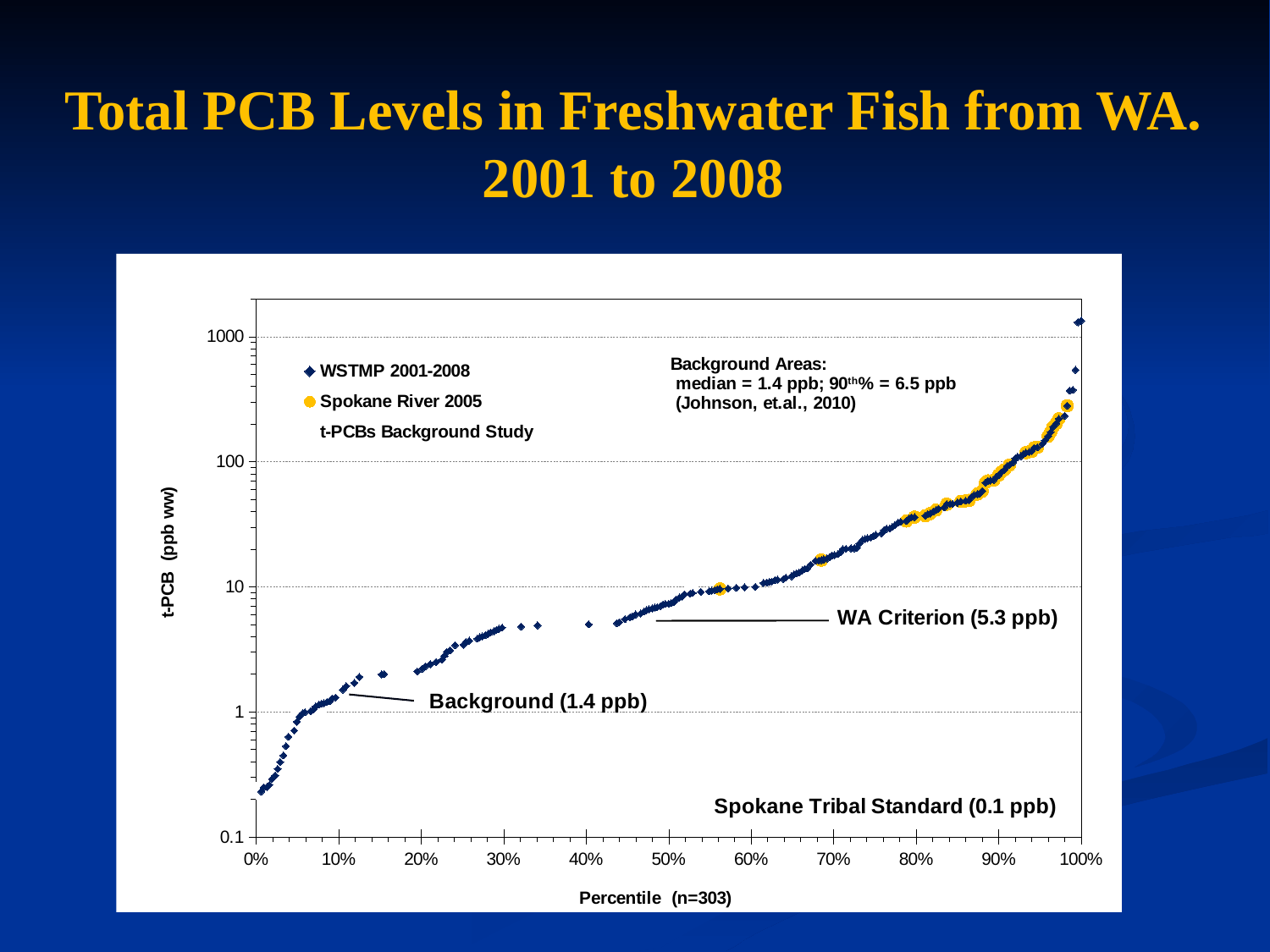
Is the highest plotted t-PCB value greater or less than 1000? greater What t-PCB value is given for the WA Criterion annotation? 5.3 ppb What kind of chart is shown on the slide? scatter chart Is the t-PCB value at the 80% percentile greater or less than 10? greater What t-PCB value is given for the Background annotation? 1.4 ppb According to the Background Areas note, what is the 90th percentile t-PCB value? 6.5 ppb What is the label of the y-axis? t-PCB (ppb ww) Is the t-PCB value at the 50% percentile greater or less than 10? less How many samples (n) does the x-axis label state? 303 What is the title of the chart on the slide? Total PCB Levels in Freshwater Fish from WA. 2001 to 2008 What t-PCB value is given for the Spokane Tribal Standard? 0.1 ppb Do the t-PCB values rise or fall as the percentile increases along the x axis? rise